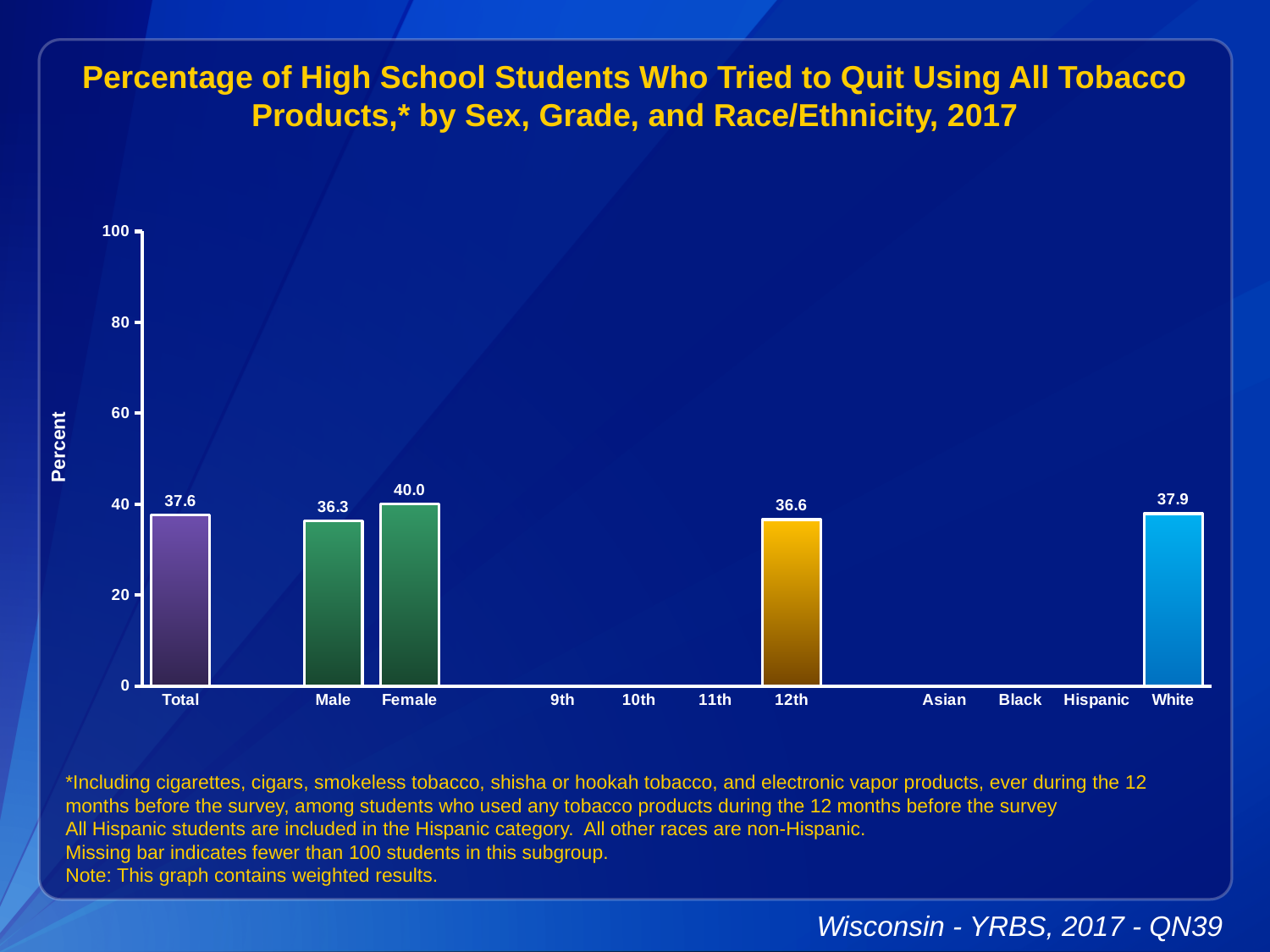
How many bars are plotted on the chart? 5 What is the label on the vertical axis? Percent What is the value for White? 37.9 Which is larger, the value for Total or the value for 12th grade? Total What kind of chart is shown on the slide? bar chart Which category has the lowest value among the bars shown? Male Is the value for Female greater or less than 20? greater Which category has the highest value among the bars shown? Female What is the value for 12th grade? 36.6 What is the difference between the Female and Male values? 3.7 What is the value for Female? 40.0 What is the value for Total? 37.6